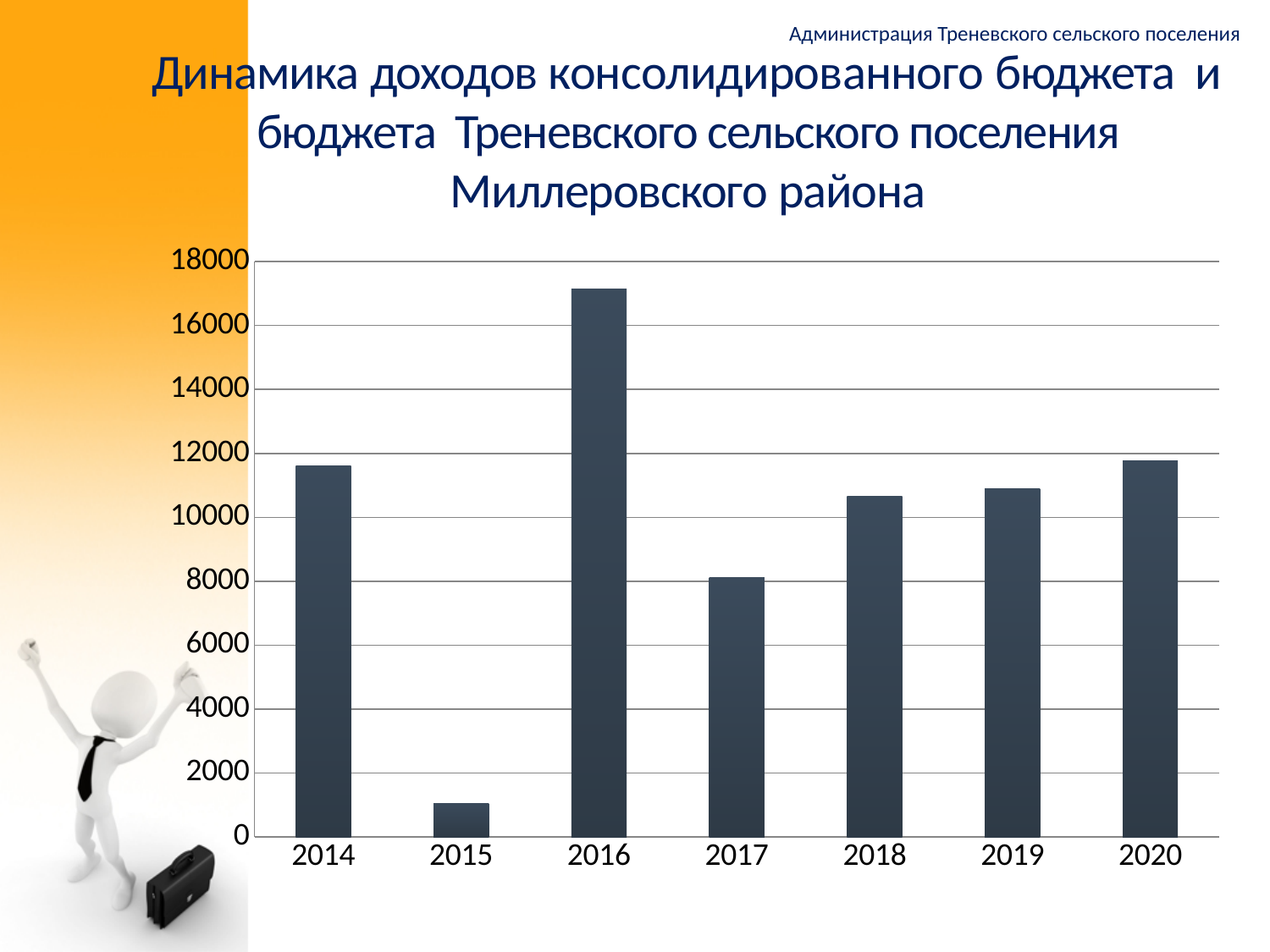
Do the values rise or fall from 2017 to 2020? rise Which is larger, the value for 2017 or the value for 2018? 2018 Is the value for 2015 greater or less than 2000? less Which is larger, the value for 2014 or the value for 2016? 2016 How many years are shown on the x axis of the chart? 7 Is the value for 2014 greater or less than 10000? greater Is the value for 2017 greater or less than 10000? less What is the highest value shown on the vertical axis of the chart? 18000 Which year has the highest value in the chart? 2016 What kind of chart is shown on the slide? bar chart Which year has the lowest value in the chart? 2015